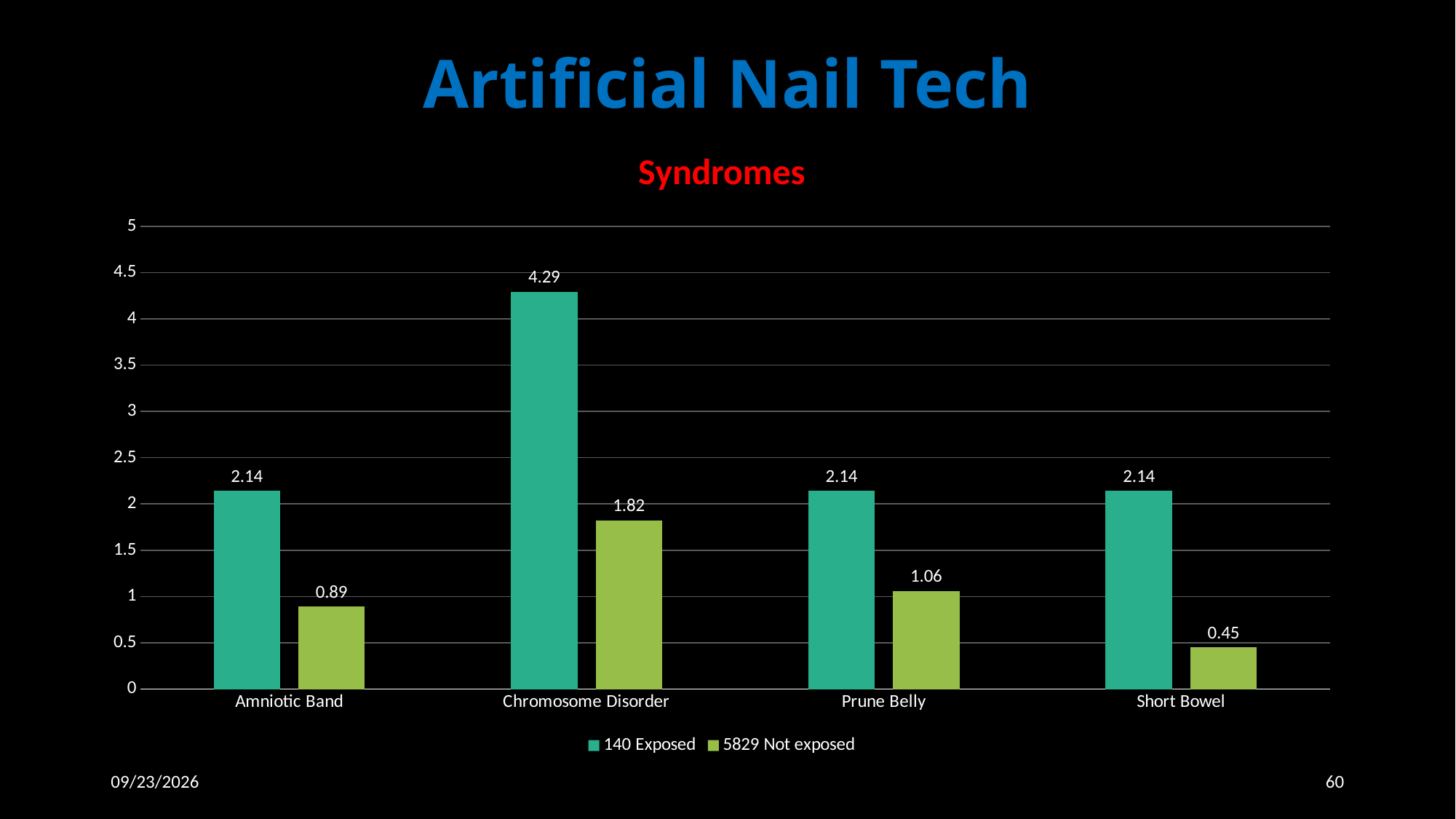
Which is larger for Prune Belly: the 140 Exposed value or the 5829 Not exposed value? 140 Exposed What is the value for 5829 Not exposed for Amniotic Band? 0.89 What kind of chart is shown on the slide? Bar chart What is the difference between the 140 Exposed and 5829 Not exposed values for Chromosome Disorder? 2.47 What is the title of the chart? Syndromes What is the value for 140 Exposed for Chromosome Disorder? 4.29 How many categories are shown on the x axis? 4 How many series does the legend list? 2 Which category has the lowest 5829 Not exposed value? Short Bowel What is the value for 140 Exposed for Prune Belly? 2.14 What is the value for 5829 Not exposed for Short Bowel? 0.45 Which category has the highest 5829 Not exposed value? Chromosome Disorder